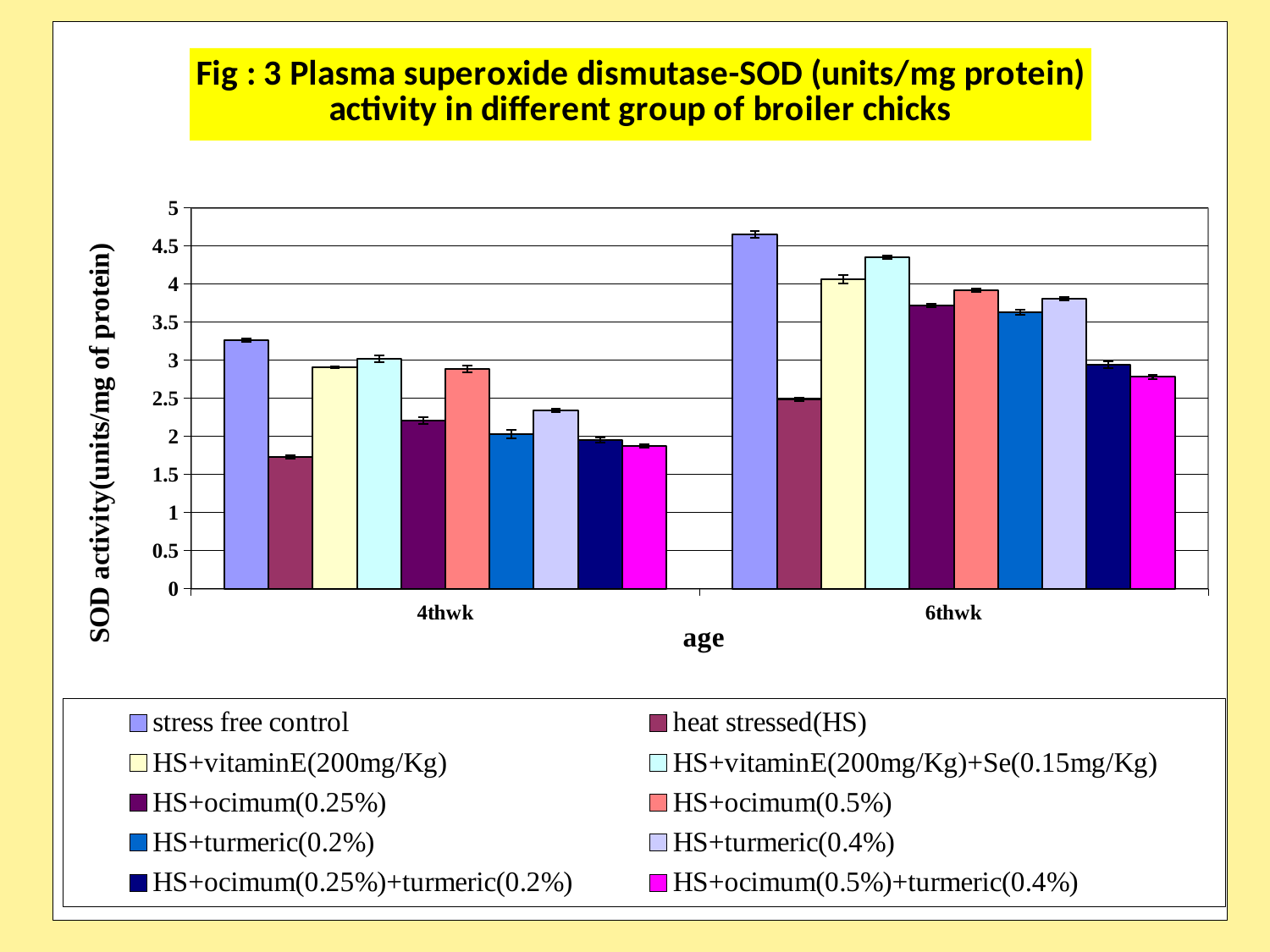
What is the title of the y axis? SOD activity(units/mg of protein) What kind of chart is shown on the slide? bar chart Which group has the highest SOD activity at 6thwk? stress free control Is the value for heat stressed(HS) at 4thwk greater or less than 2? less Which group has the lowest SOD activity at 4thwk? heat stressed(HS) At 6thwk, which is larger: HS+vitaminE(200mg/Kg)+Se(0.15mg/Kg) or HS+ocimum(0.25%)? HS+vitaminE(200mg/Kg)+Se(0.15mg/Kg) How many series does the legend list? 10 Does the SOD activity for stress free control rise or fall from 4thwk to 6thwk? rise Which group has the highest SOD activity at 4thwk? stress free control Is the value for stress free control at 6thwk greater or less than 4? greater Which group has the lowest SOD activity at 6thwk? heat stressed(HS) How many age categories are shown on the x axis? 2